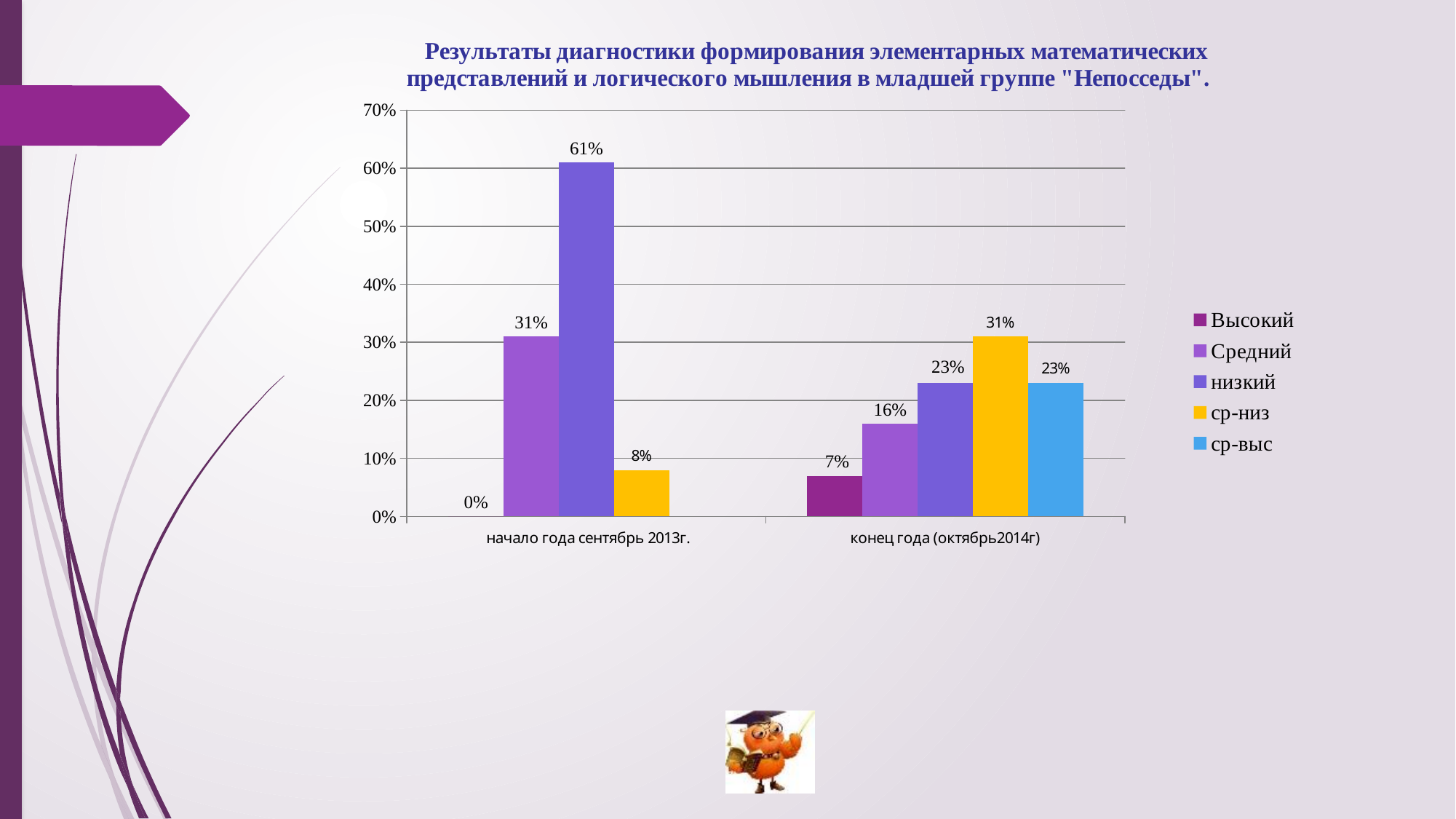
Which series has the lowest value at конец года (октябрь2014г)? Высокий What is the value for ср-низ at конец года (октябрь2014г)? 31% What is the difference between the низкий values at начало года сентябрь 2013г. and конец года (октябрь2014г)? 38% What is the value for низкий at начало года сентябрь 2013г.? 61% How many series does the legend list? 5 Which is larger: Средний at начало года сентябрь 2013г. or Средний at конец года (октябрь2014г)? начало года сентябрь 2013г. Which series has the highest value at начало года сентябрь 2013г.? низкий What is the value for Средний at начало года сентябрь 2013г.? 31% What kind of chart is shown on the slide? bar chart How many categories are shown on the x axis? 2 What is the value for Высокий at конец года (октябрь2014г)? 7% What colour represents ср-низ in the legend? yellow